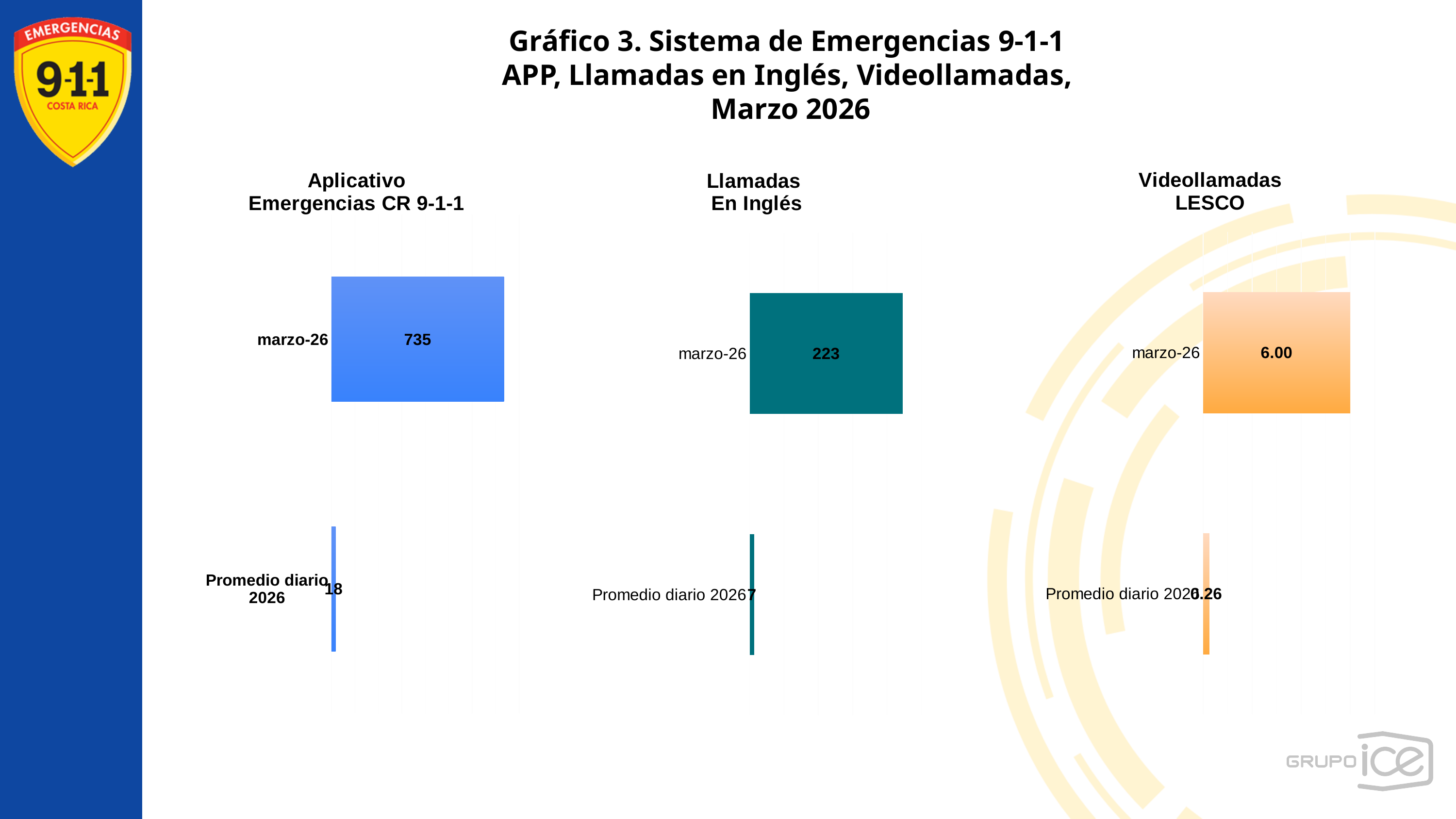
In the 'Aplicativo Emergencias CR 9-1-1' chart, which category has the highest value? marzo-26 In the 'Aplicativo Emergencias CR 9-1-1' chart, what is the value for marzo-26? 735 In the 'Aplicativo Emergencias CR 9-1-1' chart, what is the value for Promedio diario 2026? 18 In the 'Llamadas En Inglés' chart, what is the difference between the marzo-26 value and the Promedio diario 2026 value? 216 How many categories are shown in the 'Videollamadas LESCO' chart? 2 In the 'Llamadas En Inglés' chart, which category has the lowest value? Promedio diario 2026 In the 'Aplicativo Emergencias CR 9-1-1' chart, what is the difference between the marzo-26 value and the Promedio diario 2026 value? 717 In the 'Llamadas En Inglés' chart, what is the value for Promedio diario 2026? 7 In the 'Videollamadas LESCO' chart, what is the value for Promedio diario 2026? 0.26 In the 'Videollamadas LESCO' chart, what is the value for marzo-26? 6.00 What kind of chart is the 'Llamadas En Inglés' chart? Bar chart In the 'Llamadas En Inglés' chart, what is the value for marzo-26? 223